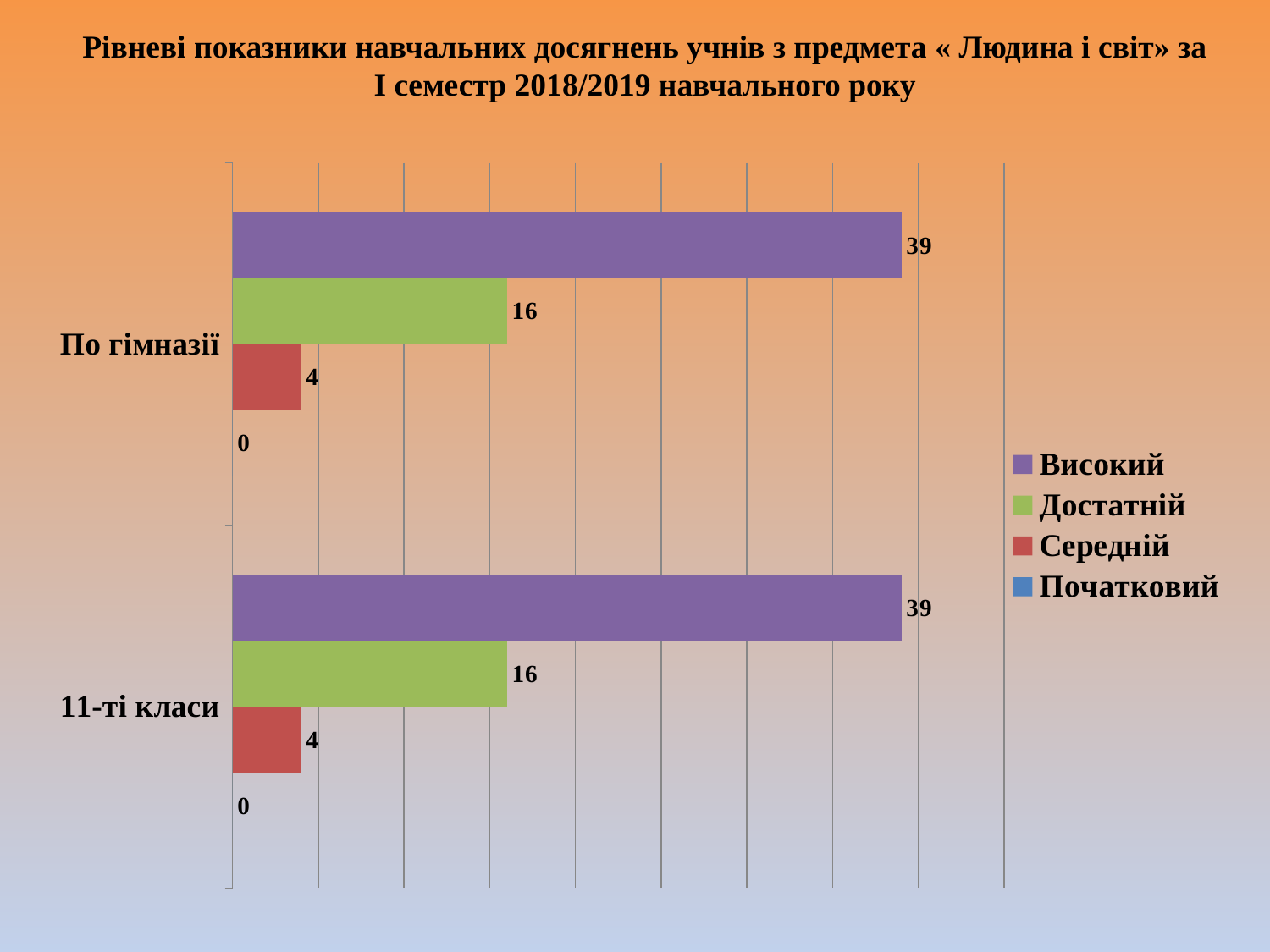
How many series does the legend list? 4 How many categories are shown on the vertical axis? 2 What is the value for Високий in the По гімназії category? 39 What kind of chart is shown on the slide? Bar chart Which is larger in the 11-ті класи category, Достатній or Середній? Достатній What is the value for Достатній in the 11-ті класи category? 16 Which series has the lowest value in the По гімназії category? Початковий Which series has the highest value in the 11-ті класи category? Високий What is the value for Середній in the По гімназії category? 4 What is the difference between the Високий and Достатній values in the По гімназії category? 23 What colour represents the Середній series in the legend? Red What is the value for Початковий in the 11-ті класи category? 0